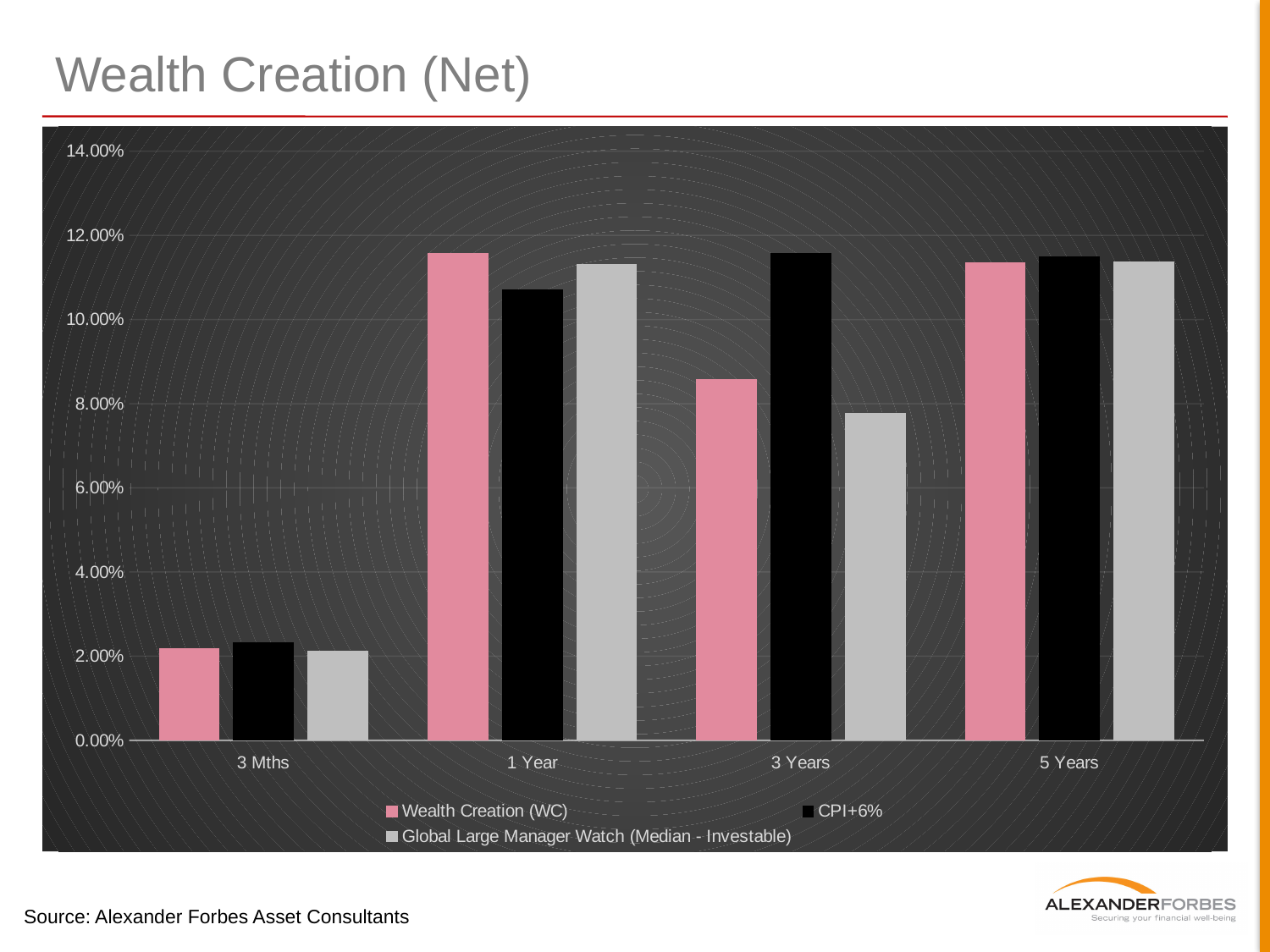
How many series does the legend list? 3 Is the value for Global Large Manager Watch (Median - Investable) at 3 Years greater or less than 10.00%? less What is the title of the slide containing the chart? Wealth Creation (Net) Is the value for Wealth Creation (WC) at 3 Mths greater or less than 4.00%? less Is the value for CPI+6% at 3 Years greater or less than 10.00%? greater At 1 Year, which is larger: Wealth Creation (WC) or CPI+6%? Wealth Creation (WC) How many time-period categories are shown on the x axis? 4 At 3 Years, which is larger: Wealth Creation (WC) or CPI+6%? CPI+6% What kind of chart is shown on the slide? bar chart Does the CPI+6% series rise or fall from 3 Mths to 3 Years? rise For the Wealth Creation (WC) series, which period has the lowest value? 3 Mths